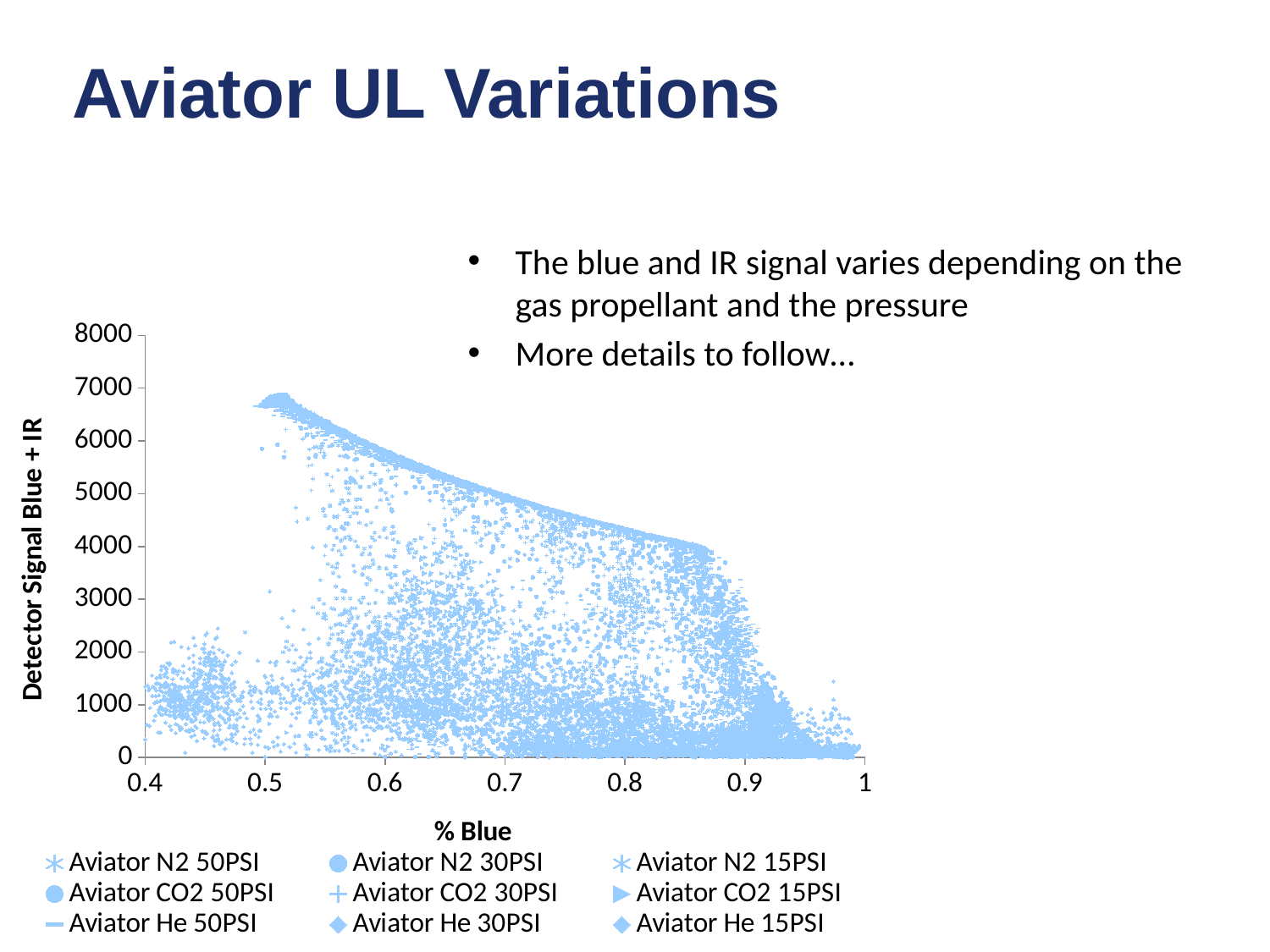
How many series does the chart's legend list? 9 Along the upper edge of the plotted data, does the detector signal rise or fall as % Blue increases from 0.5 to 0.9? fall What is the title of the chart's vertical axis? Detector Signal Blue + IR What is the title of the chart's horizontal axis? % Blue What kind of chart is shown on the slide? scatter chart